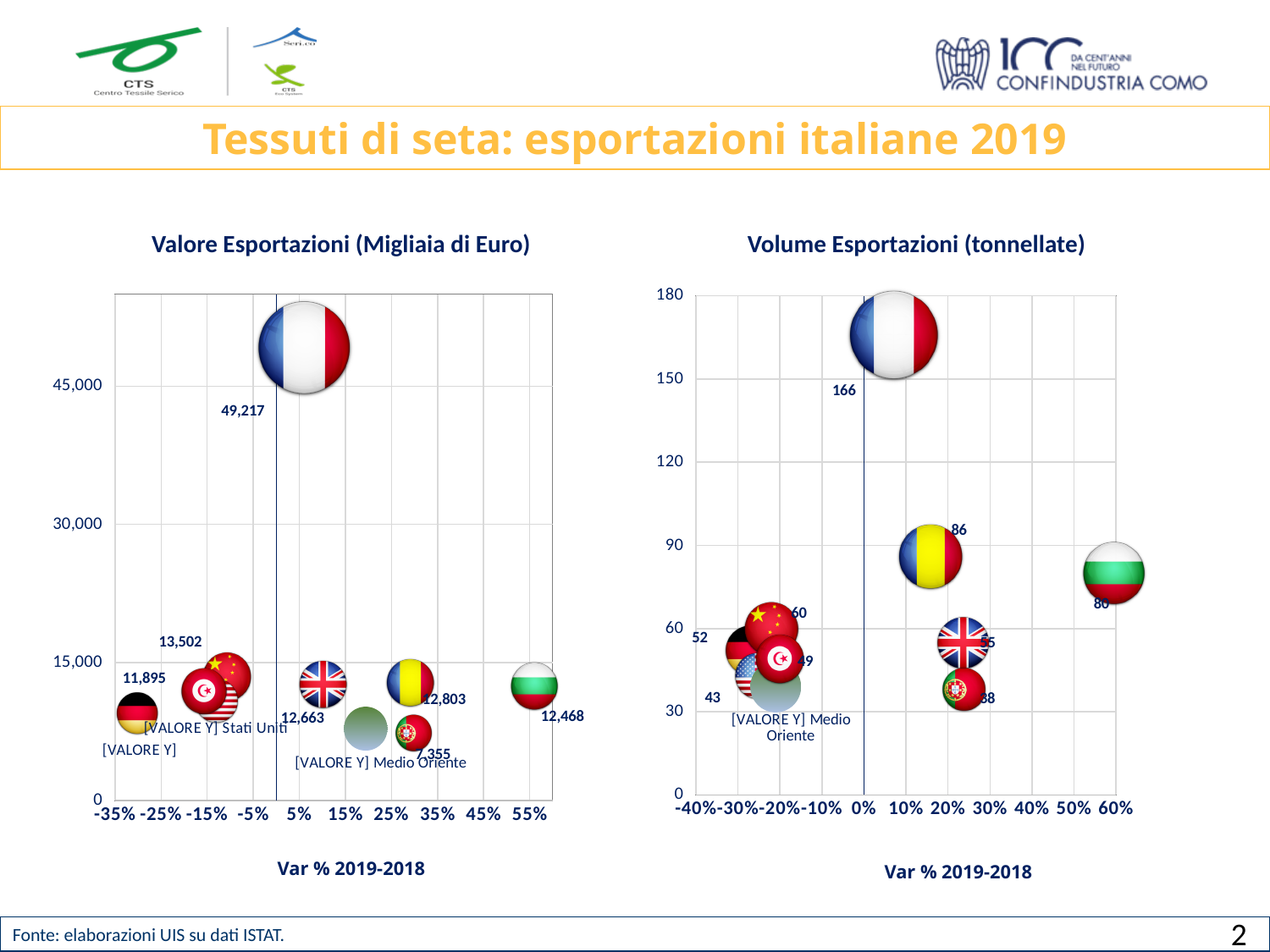
In the 'Volume Esportazioni (tonnellate)' chart, what is the lowest numeric value printed on a bubble? 38 In the 'Volume Esportazioni (tonnellate)' chart, what is the difference between the bubble labeled 166 and the bubble labeled 86? 80 In the 'Volume Esportazioni (tonnellate)' chart, what is the highest value printed on a bubble? 166 What is the highest tick shown on the y-axis of the 'Volume Esportazioni (tonnellate)' chart? 180 In the 'Valore Esportazioni (Migliaia di Euro)' chart, what is the lowest numeric value printed on a bubble? 7,355 What is the x-axis title of the 'Valore Esportazioni (Migliaia di Euro)' chart? Var % 2019-2018 In the 'Valore Esportazioni (Migliaia di Euro)' chart, what is the highest value printed on a bubble? 49,217 In the 'Volume Esportazioni (tonnellate)' chart, is the value of the bubble with the French flag greater or less than 150? greater In the 'Valore Esportazioni (Migliaia di Euro)' chart, what is the difference between the bubble labeled 12,803 and the bubble labeled 12,663? 140 In the 'Volume Esportazioni (tonnellate)' chart, what is the difference between the bubble labeled 60 and the bubble labeled 52? 8 What kind of chart is the 'Volume Esportazioni (tonnellate)' chart? bubble chart